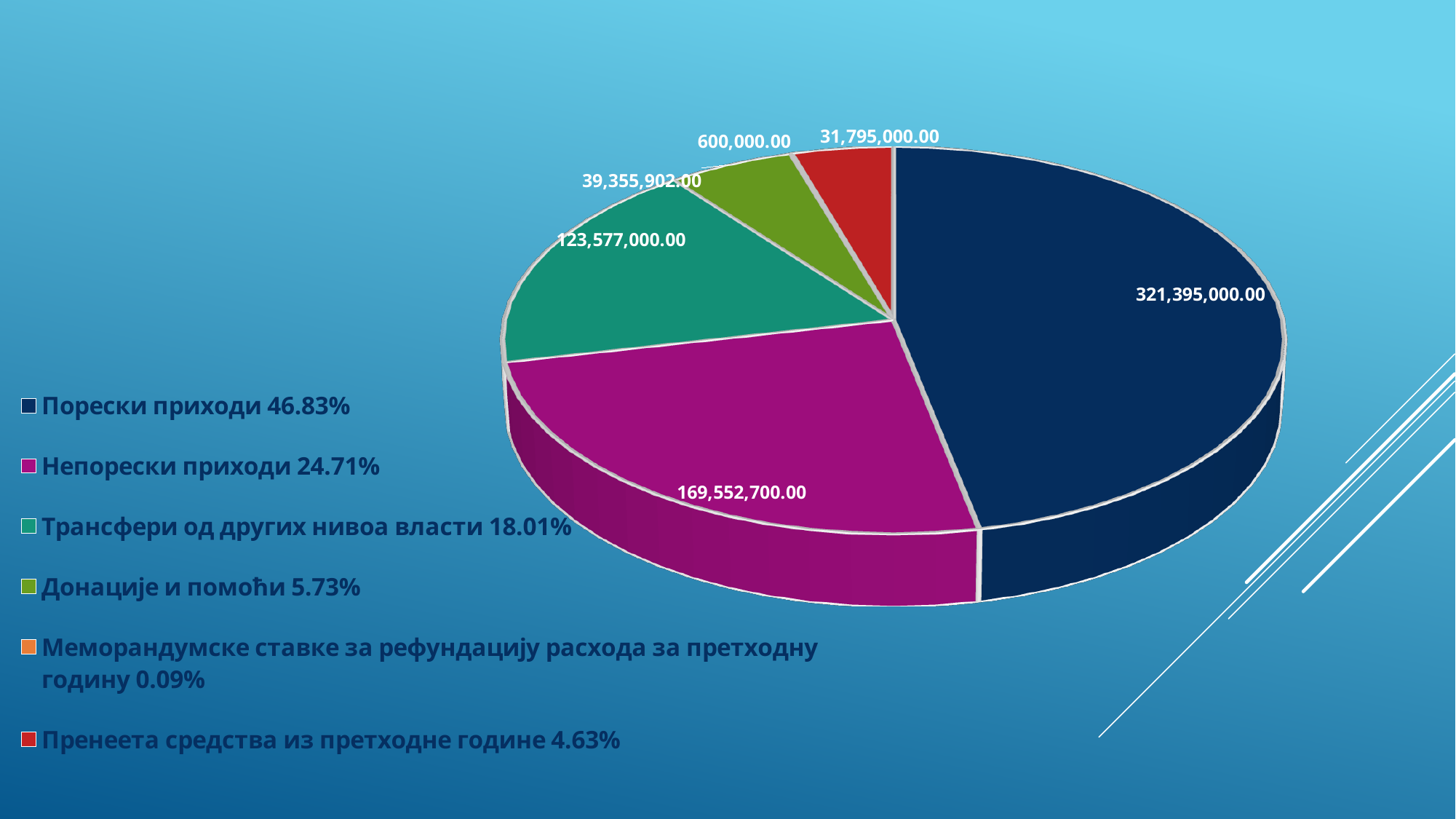
What is the value of the Непорески приходи slice? 169,552,700.00 What is the value of the Порески приходи slice? 321,395,000.00 What share of the pie does Трансфери од других нивоа власти represent? 18.01% Which category has the smallest slice of the pie? Меморандумске ставке за рефундацију расхода за претходну годину Which is larger, the Донације и помоћи slice or the Пренеета средства из претходне године slice? Донације и помоћи What is the value of the Пренеета средства из претходне године slice? 31,795,000.00 What is the difference between the Порески приходи and Непорески приходи values? 151,842,300.00 How many slices does the pie chart have? 6 What type of chart is shown on the slide? Pie chart What is the value of the Трансфери од других нивоа власти slice? 123,577,000.00 Which category has the largest slice of the pie? Порески приходи What is the value of the Донације и помоћи slice? 39,355,902.00